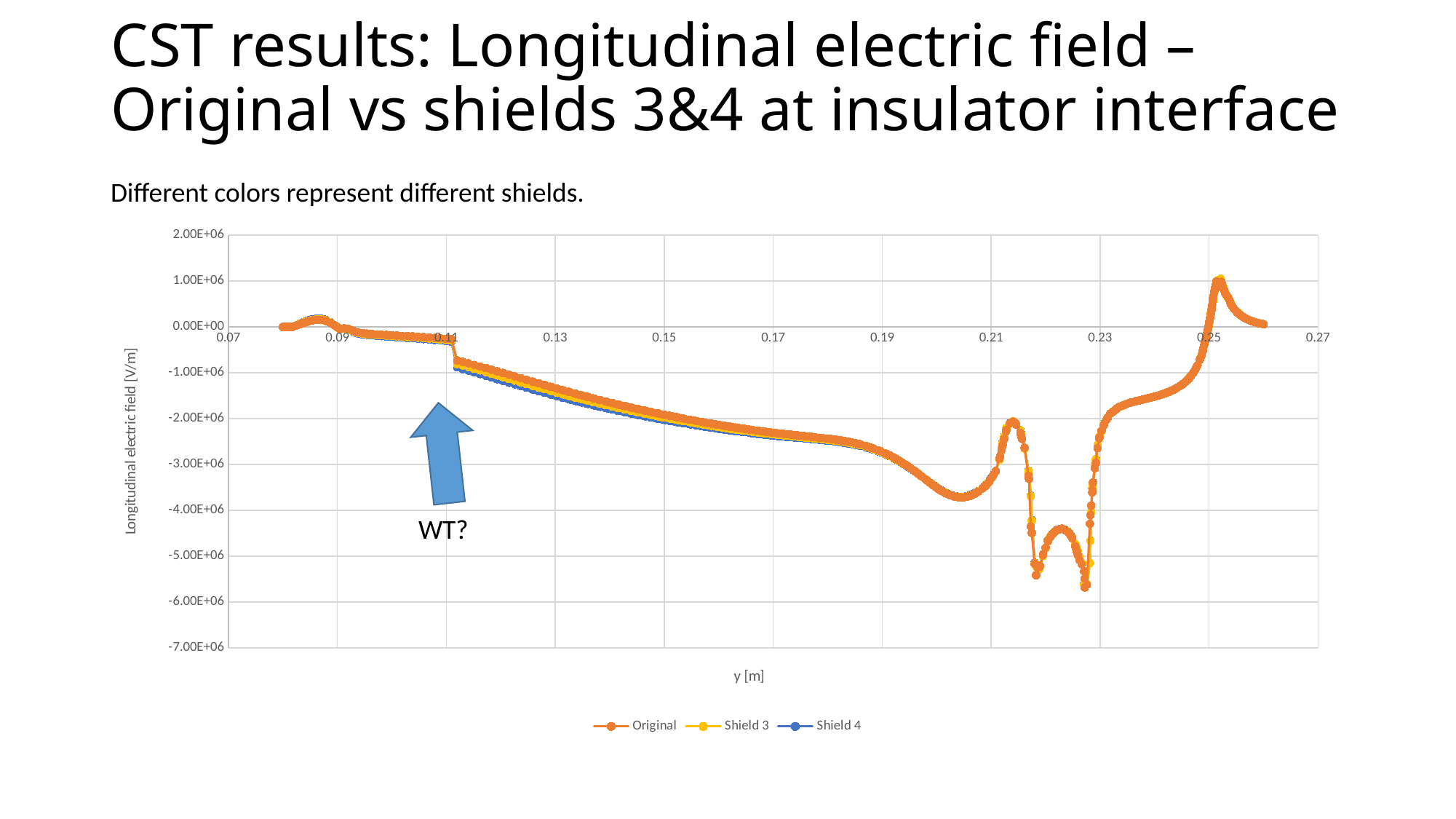
What kind of chart is shown on the slide? line chart Is the peak value of the curves near y = 0.25 greater or less than 0.00E+00? greater Is the value of the Original series at y = 0.19 greater or less than -2.00E+06? less What are the series names listed in the legend? Original, Shield 3, Shield 4 Near which x-axis tick do the curves reach their highest value? 0.25 Between y = 0.11 and y = 0.19, do the values of the curves rise or fall? fall Is the lowest value of the curves, near y = 0.23, greater or less than -5.00E+06? less Near which x-axis tick do the curves reach their lowest value? 0.23 How many series does the legend list? 3 What is the label of the x axis? y [m]